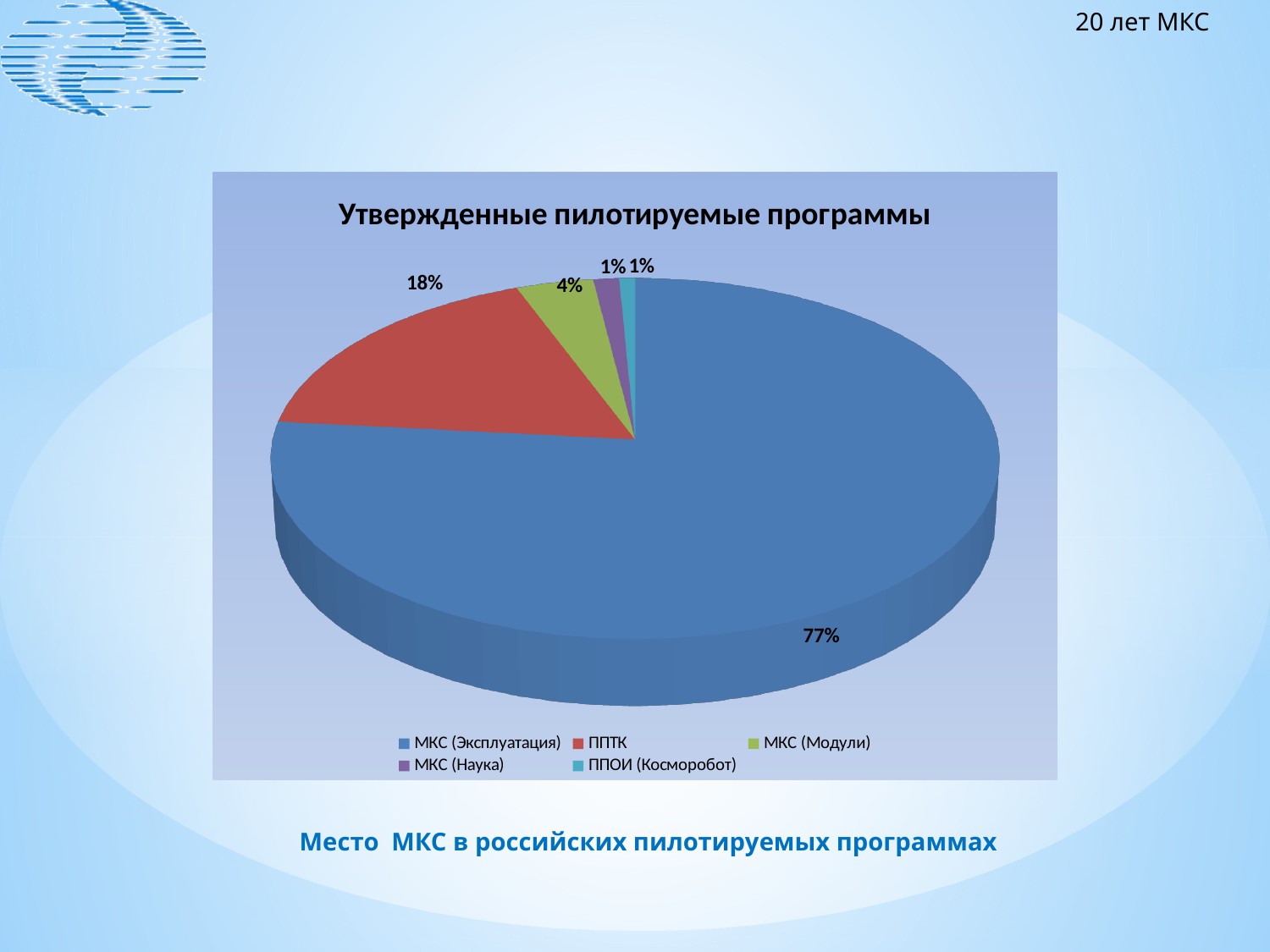
What is the title of the chart? Утвержденные пилотируемые программы Which category has the largest slice of the pie? МКС (Эксплуатация) What share of the pie does МКС (Наука) have? 1% What is the difference in percentage points between ППТК and МКС (Модули)? 14 What kind of chart is shown on the slide? pie chart What share of the pie does МКС (Эксплуатация) have? 77% Which is larger, the share for ППТК or the share for МКС (Модули)? ППТК What share of the pie does МКС (Модули) have? 4% What is the difference in percentage points between МКС (Эксплуатация) and ППТК? 59 Which colour represents ППТК in the chart? red How many categories does the legend list? 5